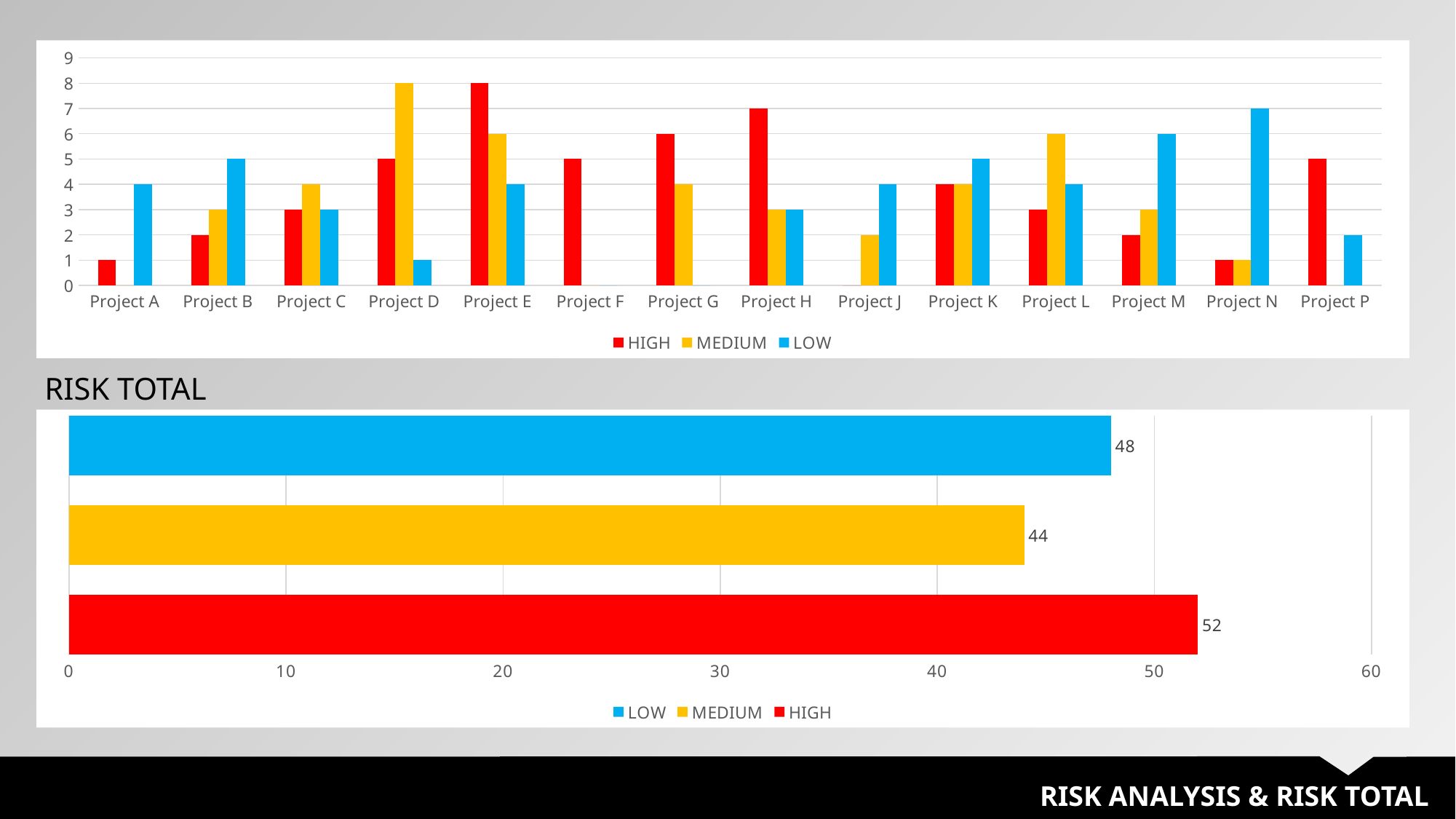
In the top chart, which has the larger HIGH value, Project G or Project H? Project H In the RISK TOTAL chart, what is the value for MEDIUM? 44 In the RISK TOTAL chart, what is the difference between the HIGH and MEDIUM values? 8 In the RISK TOTAL chart, how many series does the legend list? 3 In the top chart, what is the HIGH value for Project E? 8 What kind of chart is the RISK TOTAL chart? bar chart In the RISK TOTAL chart, which category has the lowest value? MEDIUM In the top chart, how many projects are shown on the x axis? 14 In the RISK TOTAL chart, which category has the highest value? HIGH In the top chart, what is the MEDIUM value for Project D? 8 In the top chart, what is the LOW value for Project N? 7 In the RISK TOTAL chart, what is the value for HIGH? 52